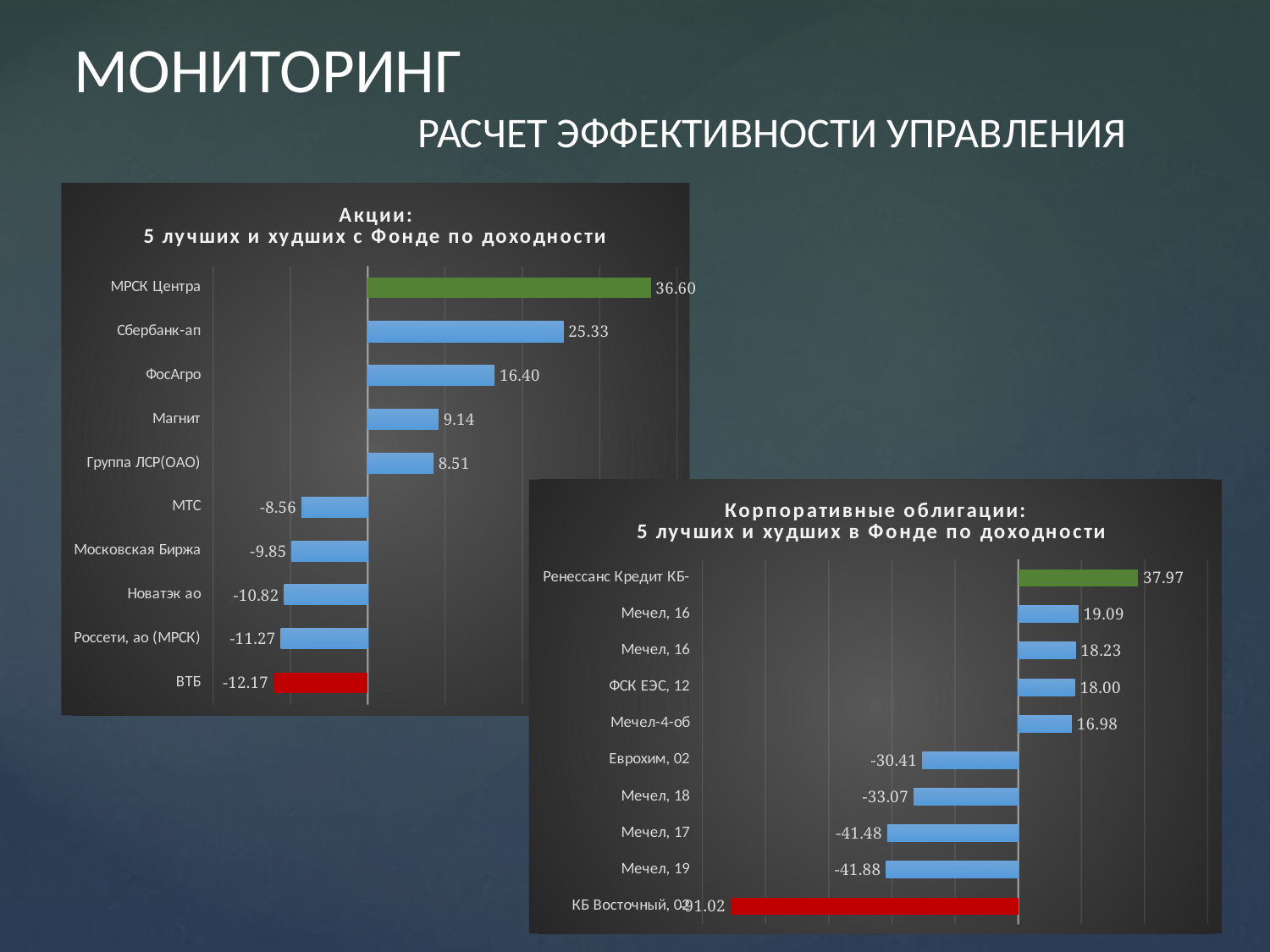
In the chart titled "Корпоративные облигации: 5 лучших и худших в Фонде по доходности", what is the value for Еврохим, 02? -30.41 In the chart titled "Корпоративные облигации: 5 лучших и худших в Фонде по доходности", which category has the highest value? Ренессанс Кредит КБ- In the chart titled "Корпоративные облигации: 5 лучших и худших в Фонде по доходности", what is the value for Ренессанс Кредит КБ-? 37.97 In the chart titled "Корпоративные облигации: 5 лучших и худших в Фонде по доходности", what is the difference between the values for ФСК ЕЭС, 12 and Мечел-4-об? 1.02 In the chart titled "Акции: 5 лучших и худших с Фонде по доходности", which category has the lowest value? ВТБ In the chart titled "Акции: 5 лучших и худших с Фонде по доходности", which is larger: the value for МТС or the value for Новатэк ао? МТС In the chart titled "Акции: 5 лучших и худших с Фонде по доходности", what is the value for МРСК Центра? 36.60 What type of chart is the chart titled "Корпоративные облигации: 5 лучших и худших в Фонде по доходности"? Bar chart In the chart titled "Корпоративные облигации: 5 лучших и худших в Фонде по доходности", what colour is the bar for КБ Восточный, 02? Red In the chart titled "Акции: 5 лучших и худших с Фонде по доходности", what is the value for ФосАгро? 16.40 How many categories are shown in the chart titled "Акции: 5 лучших и худших с Фонде по доходности"? 10 In the chart titled "Акции: 5 лучших и худших с Фонде по доходности", what is the difference between the values for Сбербанк-ап and Магнит? 16.19